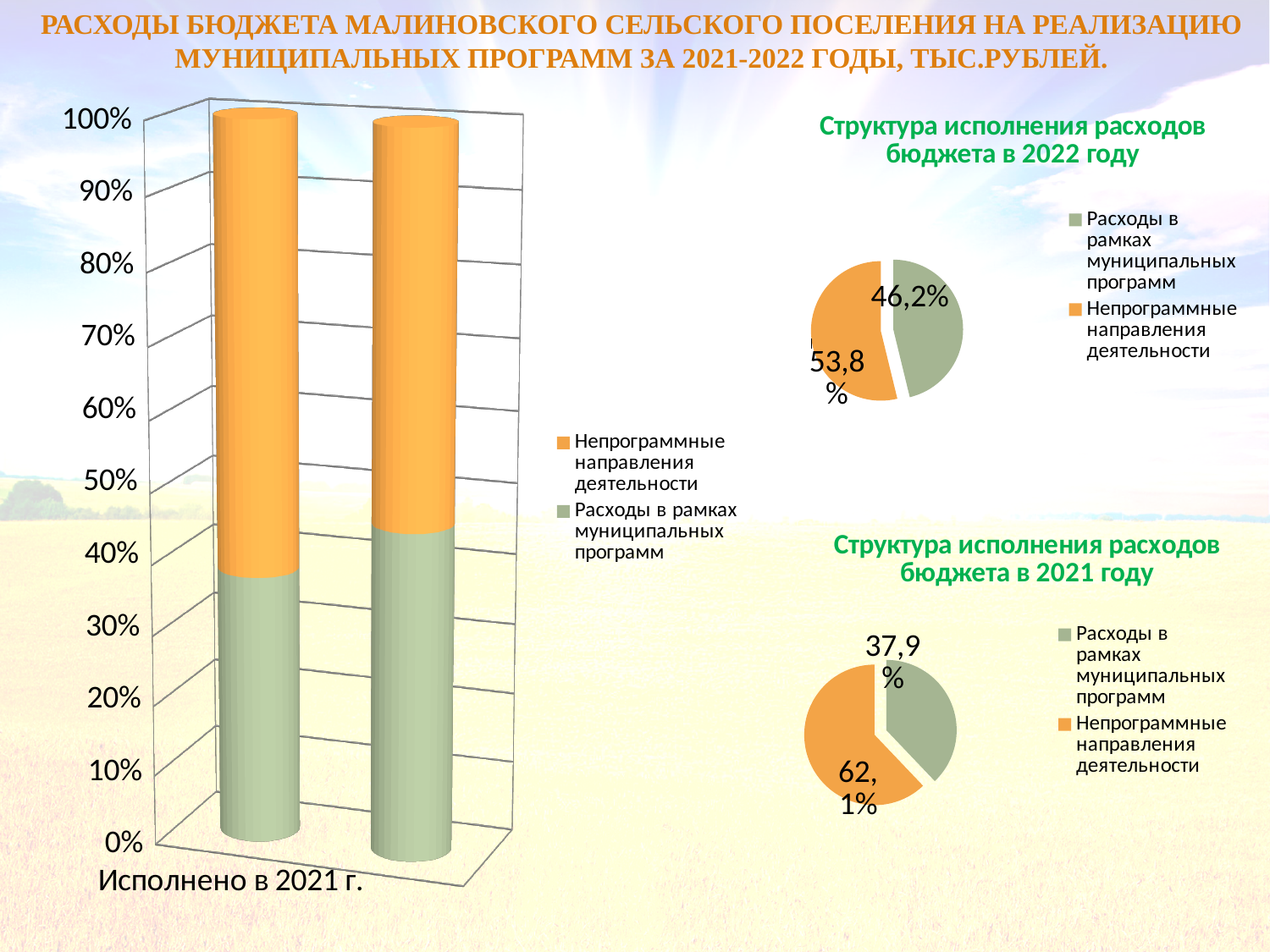
In the bar chart on the left, is the value of 'Расходы в рамках муниципальных программ' for 'Исполнено в 2021 г.' greater or less than 50%? less How many slices does the pie chart for 2022 have? 2 How many series does the legend of the bar chart on the left list? 2 In the pie chart titled 'Структура исполнения расходов бюджета в 2022 году', what share is shown for 'Расходы в рамках муниципальных программ'? 46,2% In the pie chart titled 'Структура исполнения расходов бюджета в 2021 году', what share is shown for 'Непрограммные направления деятельности'? 62,1% In the pie chart for 2022, which slice is the smallest? Расходы в рамках муниципальных программ What kind of chart is the large chart on the left side of the slide? Stacked bar chart In the pie chart titled 'Структура исполнения расходов бюджета в 2022 году', what share is shown for 'Непрограммные направления деятельности'? 53,8% In the pie chart for 2021, which slice is the largest? Непрограммные направления деятельности In the pie chart for 2021, what is the difference between the share of 'Непрограммные направления деятельности' and the share of 'Расходы в рамках муниципальных программ'? 24,2% In the pie chart titled 'Структура исполнения расходов бюджета в 2021 году', what share is shown for 'Расходы в рамках муниципальных программ'? 37,9% Which is larger: the share of 'Расходы в рамках муниципальных программ' in the 2022 pie chart or in the 2021 pie chart? 2022